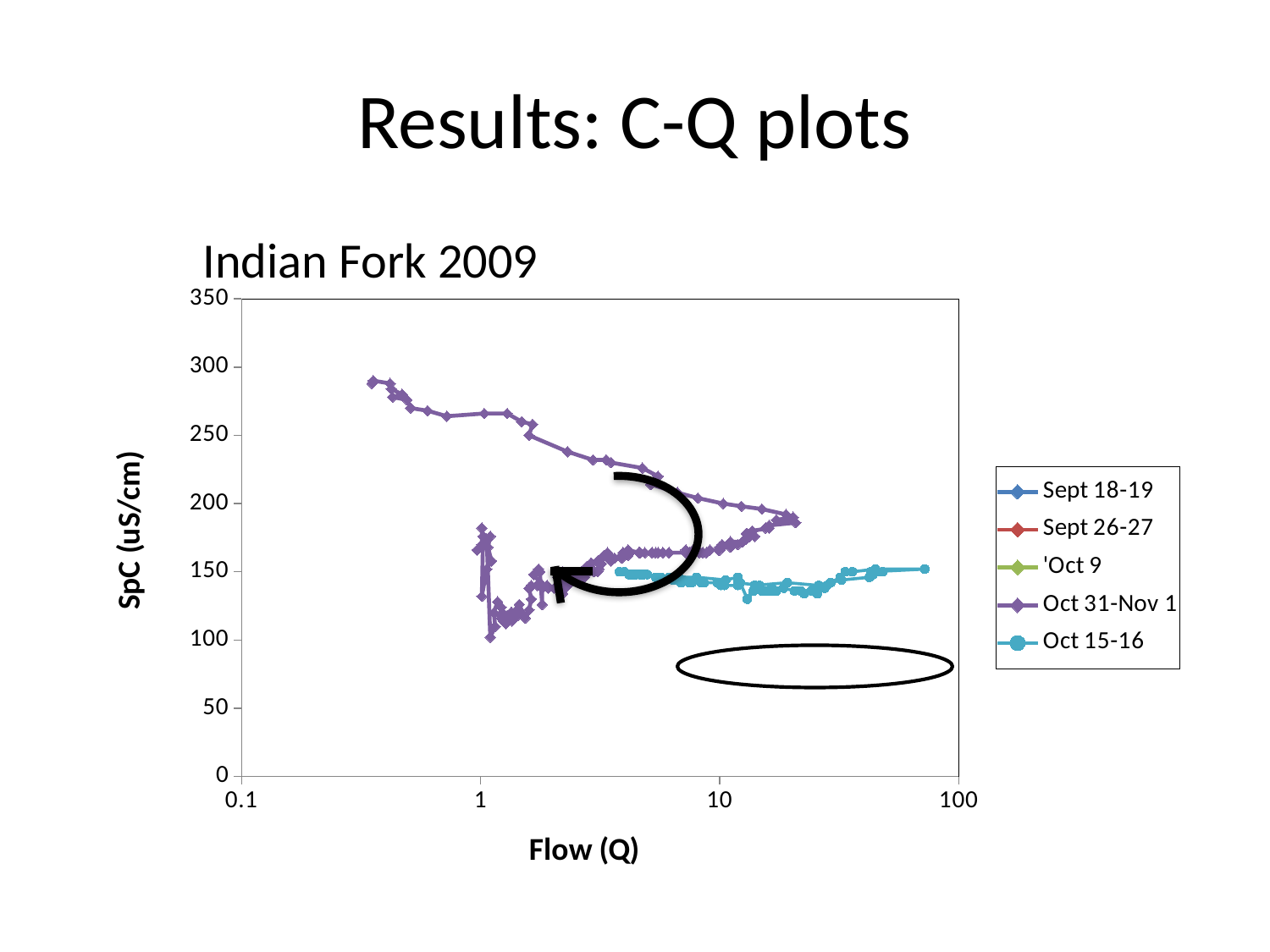
Is the highest SpC value plotted for the Oct 31-Nov 1 series greater or less than 250? greater Are the SpC values plotted for the Oct 15-16 series greater or less than 200? less What kind of chart is shown on the slide? scatter plot Along the upper branch of the Oct 31-Nov 1 series, does SpC rise or fall as flow increases? fall Which plotted series extends to the highest flow (Q) value on the chart? Oct 15-16 Which series reaches a higher SpC value, Oct 31-Nov 1 or Oct 15-16? Oct 31-Nov 1 Which plotted series has the highest SpC value on the chart? Oct 31-Nov 1 How many series does the legend list? 5 Is the lowest SpC value plotted for the Oct 15-16 series greater or less than 100? greater What is the label on the y axis of the chart? SpC (uS/cm) What is the title of the chart? Indian Fork 2009